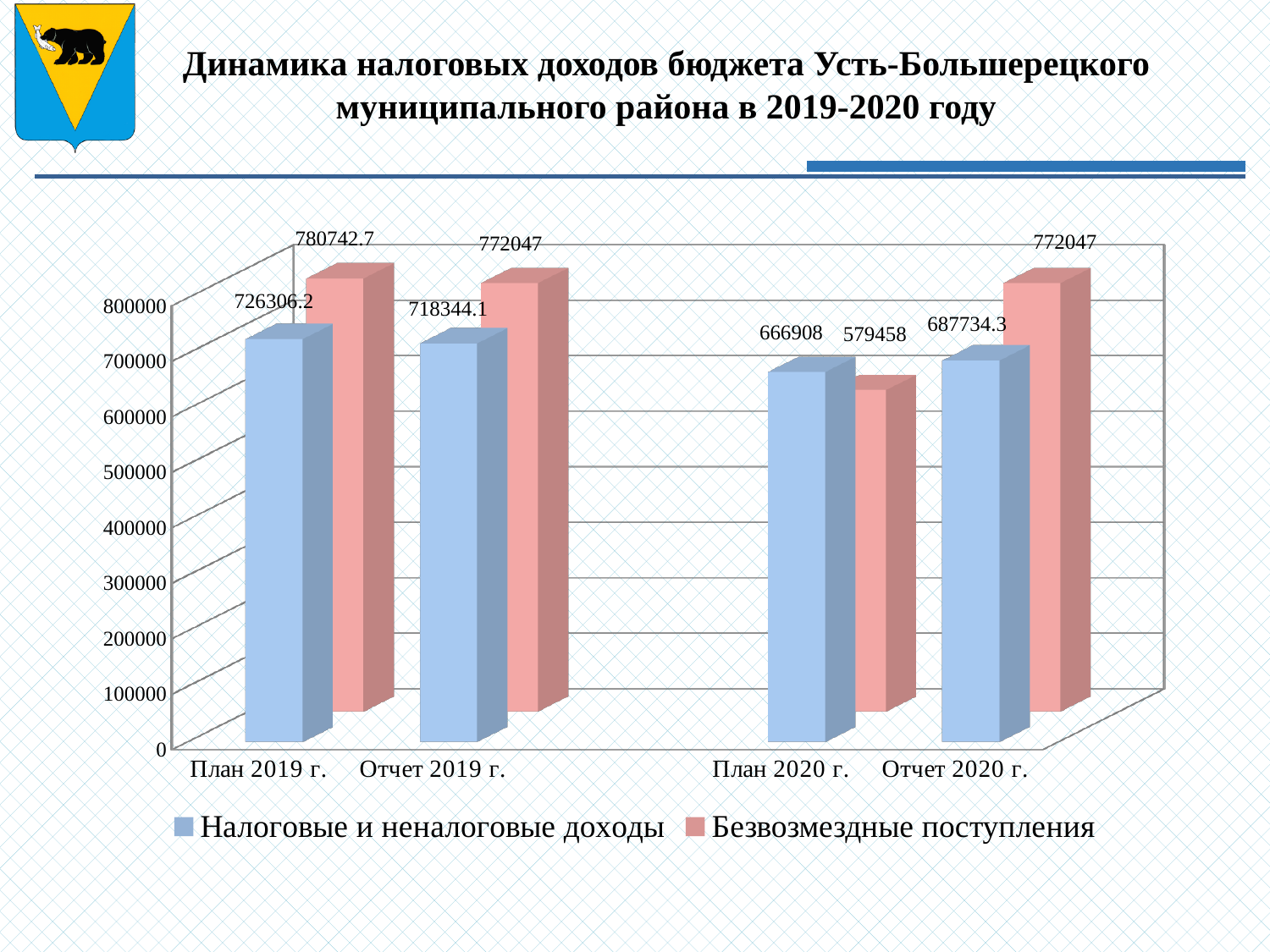
What kind of chart is shown on the slide? Bar chart What is the difference between Безвозмездные поступления and Налоговые и неналоговые доходы for Отчет 2020 г.? 84312.7 What is the value of Безвозмездные поступления for План 2020 г.? 579458 How many categories are shown on the x axis? 4 Which category has the lowest value for Безвозмездные поступления? План 2020 г. What is the value of Налоговые и неналоговые доходы for План 2019 г.? 726306.2 For План 2020 г., which is larger: Налоговые и неналоговые доходы or Безвозмездные поступления? Налоговые и неналоговые доходы Which category has the highest value for Налоговые и неналоговые доходы? План 2019 г. What is the value of Налоговые и неналоговые доходы for Отчет 2020 г.? 687734.3 What is the value of Безвозмездные поступления for План 2019 г.? 780742.7 Which colour represents Безвозмездные поступления in the chart? Pink How many series does the legend list? 2